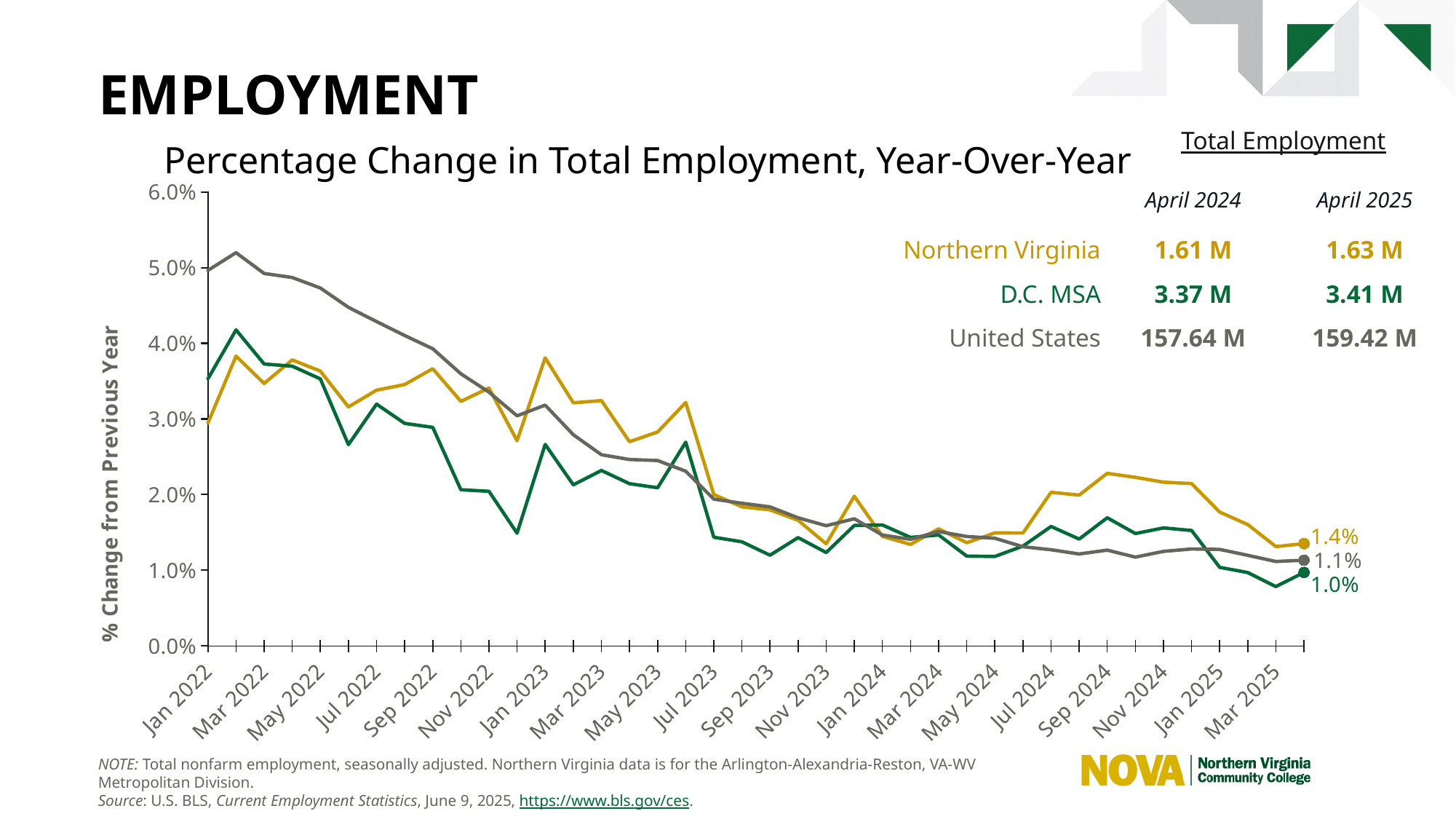
At the final point on the chart, which series has the highest value? Northern Virginia Is the value for the United States in Jan 2022 greater or less than 4.0%? greater Overall, do the year-over-year percentage changes rise or fall from Jan 2022 to the end of the chart? fall How many series are plotted on the chart? 3 What is the latest labelled value for the D.C. MSA on the chart? 1.0% What is the title of the chart? Percentage Change in Total Employment, Year-Over-Year What kind of chart is shown on the slide? line chart What is the difference between the final labelled values for Northern Virginia and the D.C. MSA? 0.4 percentage points At the final point, is the value for the United States larger or smaller than the value for the D.C. MSA? larger At the final point on the chart, which series has the lowest value? D.C. MSA What is the latest labelled value for Northern Virginia on the chart? 1.4% What is the latest labelled value for the United States on the chart? 1.1%